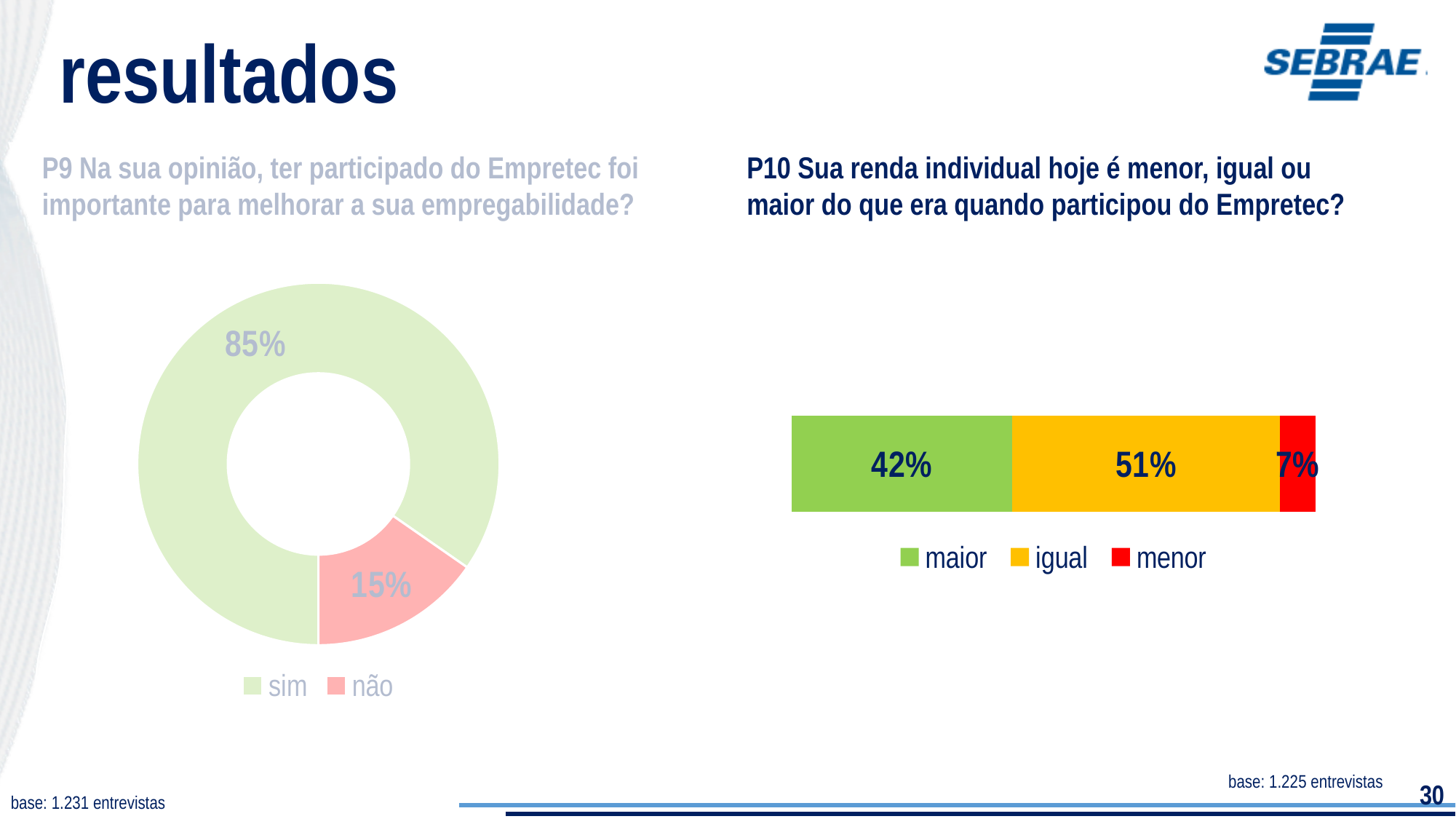
In the P9 chart on the left, what is the difference between the "sim" and "não" shares? 70 percentage points In the P10 chart on the right, what percentage answered "maior"? 42% In the P10 chart on the right, what percentage answered "menor"? 7% In the P10 chart on the right, what colour represents "menor"? Red In the P9 chart on the left, what percentage answered "não"? 15% In the P10 chart on the right, which response has the lowest share? menor What kind of chart is the P9 chart on the left? Doughnut (pie) chart In the P10 chart on the right, what percentage answered "igual"? 51% In the P9 chart on the left, what percentage answered "sim"? 85% In the P10 chart on the right, which response has the highest share? igual How many entries does the legend of the P9 chart on the left list? 2 In the P10 chart on the right, what is the difference between the "igual" and "maior" shares? 9 percentage points